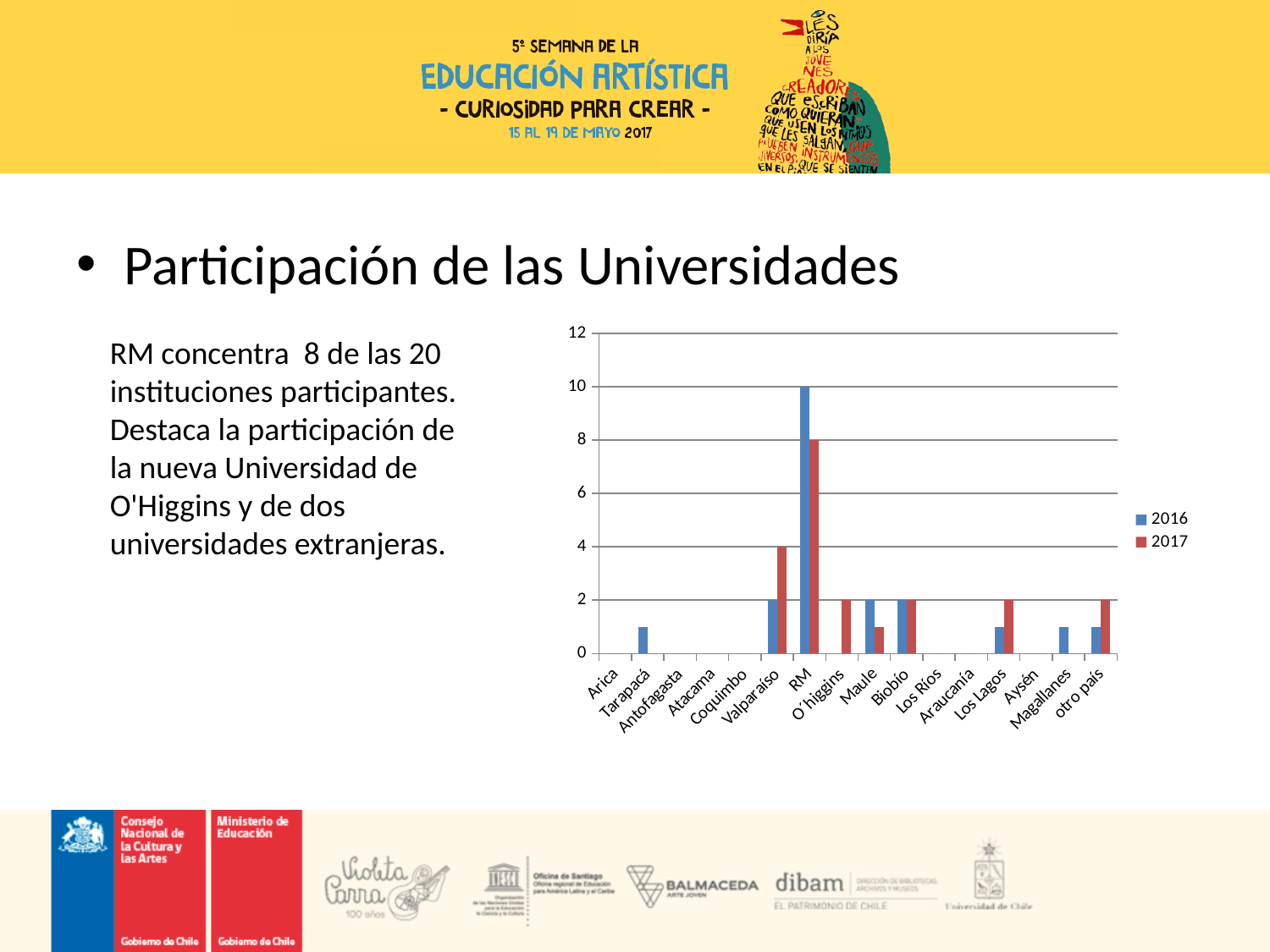
What is the value for Valparaíso in the 2017 series? 4 Which category has the highest value in the 2016 series? RM What is the value for Biobío in the 2016 series? 2 What kind of chart is shown on the slide? bar chart Is the 2016 value for Tarapacá greater or less than 2? less How many series does the chart's legend list? 2 What is the difference between the 2016 and 2017 values for RM? 2 How many categories are shown along the x axis of the chart? 16 What are the two entries listed in the chart's legend? 2016 and 2017 What is the value for RM in the 2016 series? 10 For Valparaíso, which series has the larger value, 2016 or 2017? 2017 What is the value for RM in the 2017 series? 8